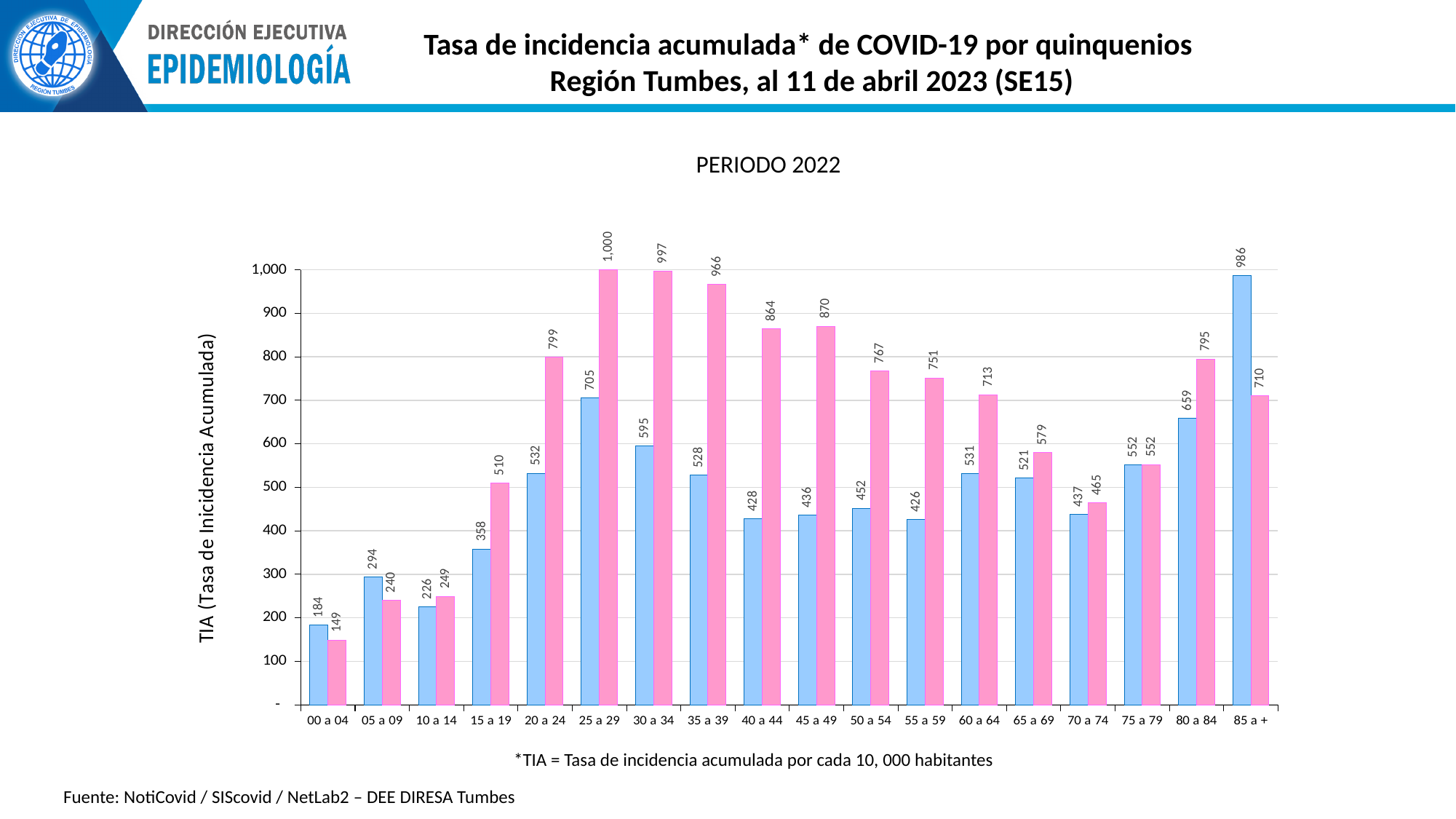
Which is larger for the 85 a + age group, the blue bar or the pink bar? the blue bar What is the difference between the pink bar and the blue bar for the 20 a 24 age group? 267 What is the value of the blue bar for the 40 a 44 age group? 428 What type of chart is shown on the slide? bar chart Which age group has the highest pink bar? 25 a 29 What is the value of the pink bar for the 75 a 79 age group? 552 How many age-group categories are shown on the x axis? 18 What is the chart's title? PERIODO 2022 Which age group has the lowest blue bar? 00 a 04 What is the value of the blue bar for the 85 a + age group? 986 What is the y-axis label of the chart? TIA (Tasa de Incidencia Acumulada) What is the value of the pink bar for the 25 a 29 age group? 1,000